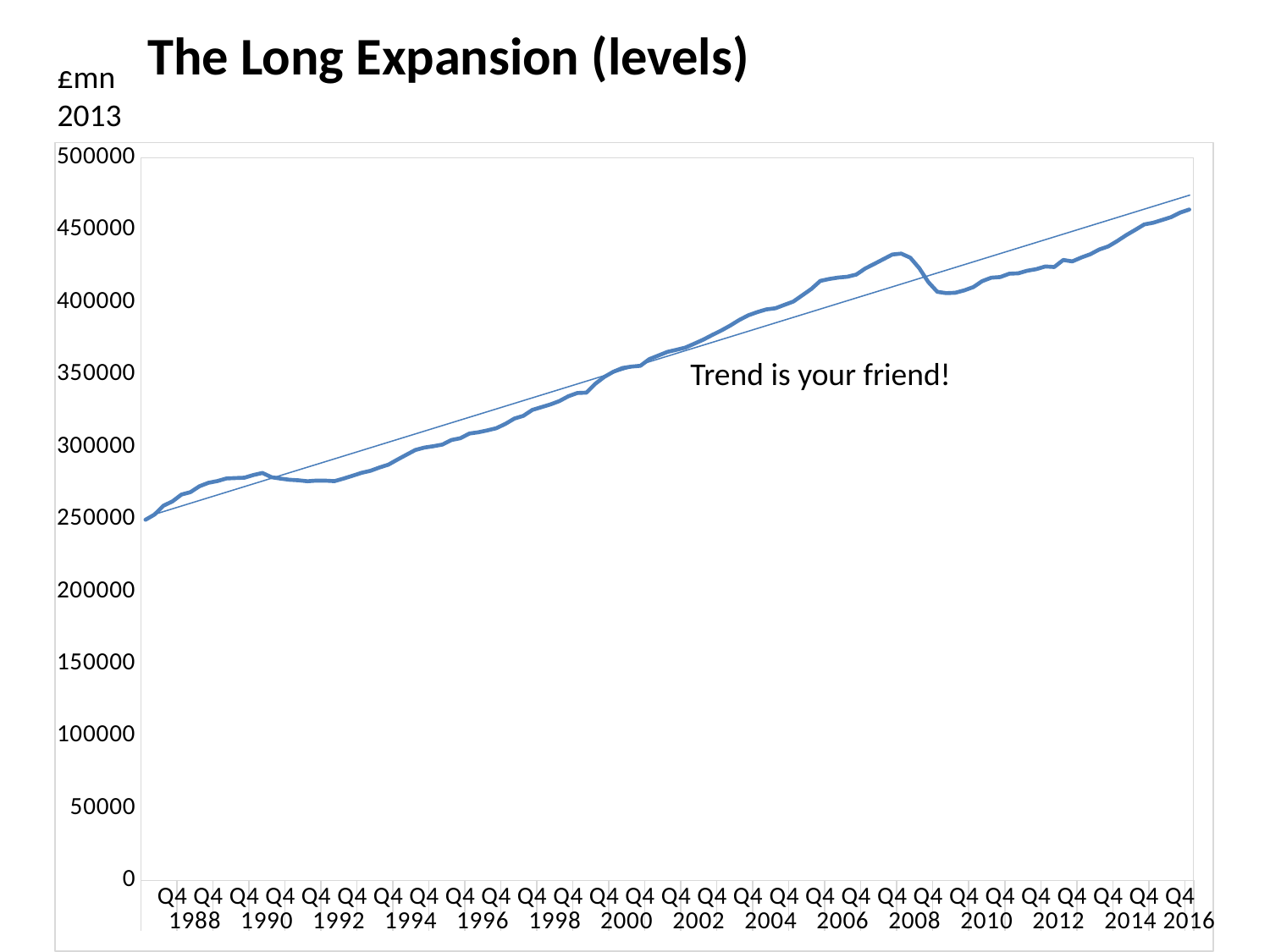
Is the value at Q4 1992 greater or less than 300000? less Is the value at Q4 2000 greater or less than 300000? greater Overall, do the values rise or fall from Q4 1988 to Q4 2016? rise At which labelled x-axis point is the plotted line at its lowest? Q4 1988 Is the value at Q4 2010 greater or less than 350000? greater What is the title of the chart? The Long Expansion (levels) How many year labels are shown along the x axis? 15 At which labelled x-axis point is the plotted line at its highest? Q4 2016 What kind of chart is shown on the slide? line chart What text annotation is written on the chart near the plotted line? Trend is your friend!